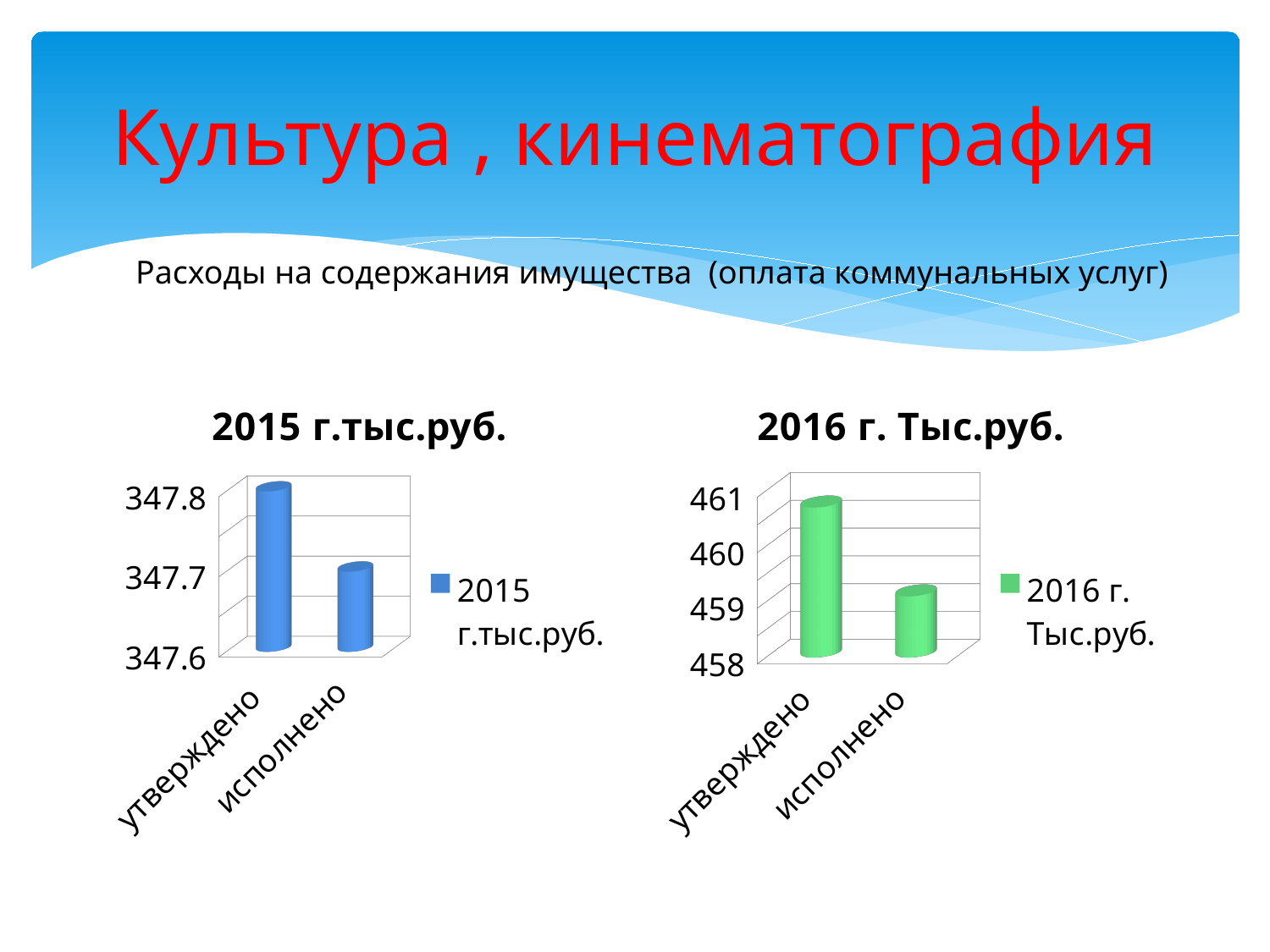
What colour are the bars in the "2015 г.тыс.руб." chart? blue What is the legend entry of the chart on the right? 2016 г. Тыс.руб. What kind of chart is the "2015 г.тыс.руб." chart? bar chart How many categories are shown in the "2016 г. Тыс.руб." chart? 2 In the "2015 г.тыс.руб." chart, is the value for исполнено greater or less than 347.8? less In the "2015 г.тыс.руб." chart, is the value for утверждено greater or less than 347.7? greater How many series does the legend of the "2015 г.тыс.руб." chart list? 1 In the "2016 г. Тыс.руб." chart, is the value for исполнено greater or less than 460? less In the "2015 г.тыс.руб." chart, which category has the highest value? утверждено In the "2016 г. Тыс.руб." chart, which category has the lowest value? исполнено In the "2016 г. Тыс.руб." chart, which is larger: утверждено or исполнено? утверждено